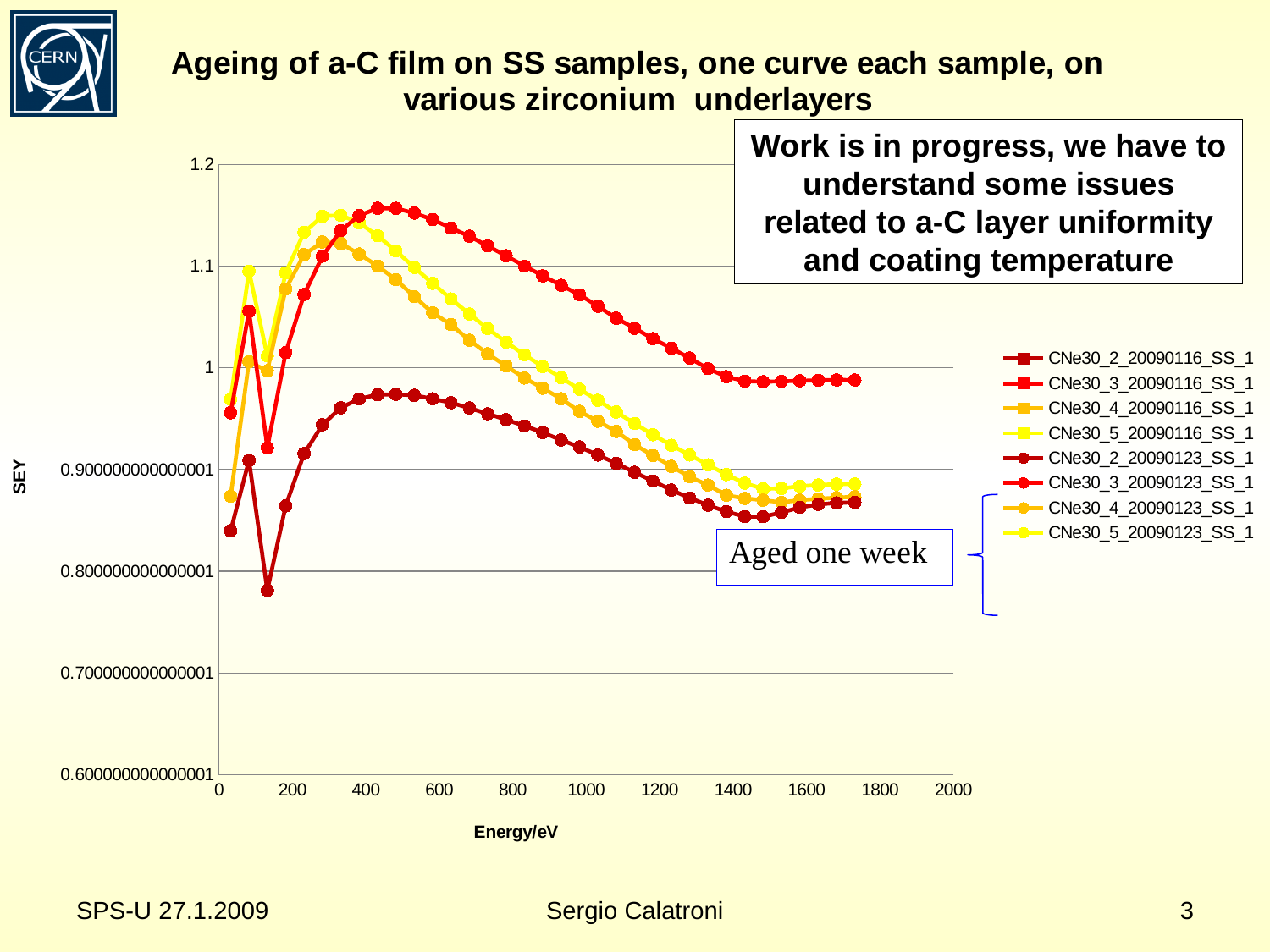
Is the peak value of the lowest (dark red) curve greater or less than 1? less At 400 eV, is the SEY of the red curve larger or smaller than that of the dark red curve? larger Is the value of the dark red curve at 1600 eV greater or less than 0.9? less What is the title of the y axis of the chart? SEY How many series does the chart legend list? 8 Between 600 eV and 1400 eV, does the red curve rise or fall as energy increases? fall At 1000 eV, which plotted curve has the lowest SEY value? CNe30_2_20090123_SS_1 At 1000 eV, which plotted curve has the highest SEY value? CNe30_3_20090123_SS_1 Is the peak value of the highest (red) curve greater or less than 1.1? greater What kind of chart is shown on the slide? line chart What is the title of the x axis of the chart? Energy/eV